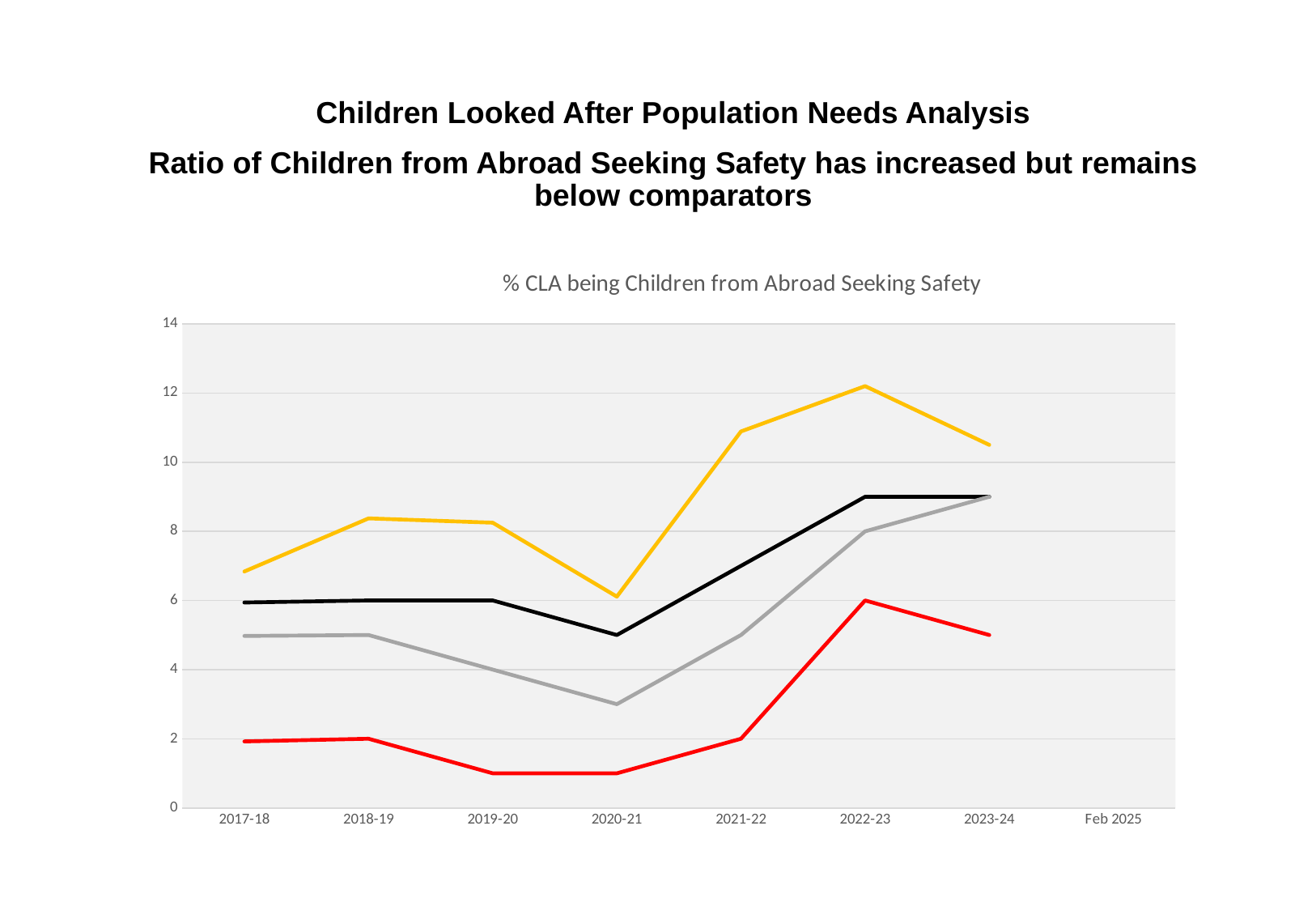
Does the red line rise or fall between 2020-21 and 2022-23? rise How many category labels are shown on the x axis? 8 Is the value of the red line in 2019-20 greater or less than 2? less Which line has the lowest value in 2017-18? the red line Is the value of the yellow line in 2022-23 greater or less than 12? greater What is the title of the chart? % CLA being Children from Abroad Seeking Safety Which is larger in 2021-22, the value of the black line or the value of the grey line? the black line In which year does the yellow line reach its highest value? 2022-23 What kind of chart is shown on the slide? line chart Which line has the highest value in 2023-24? the yellow line Is the value of the grey line in 2020-21 greater or less than 4? less How many lines are plotted on the chart? 4